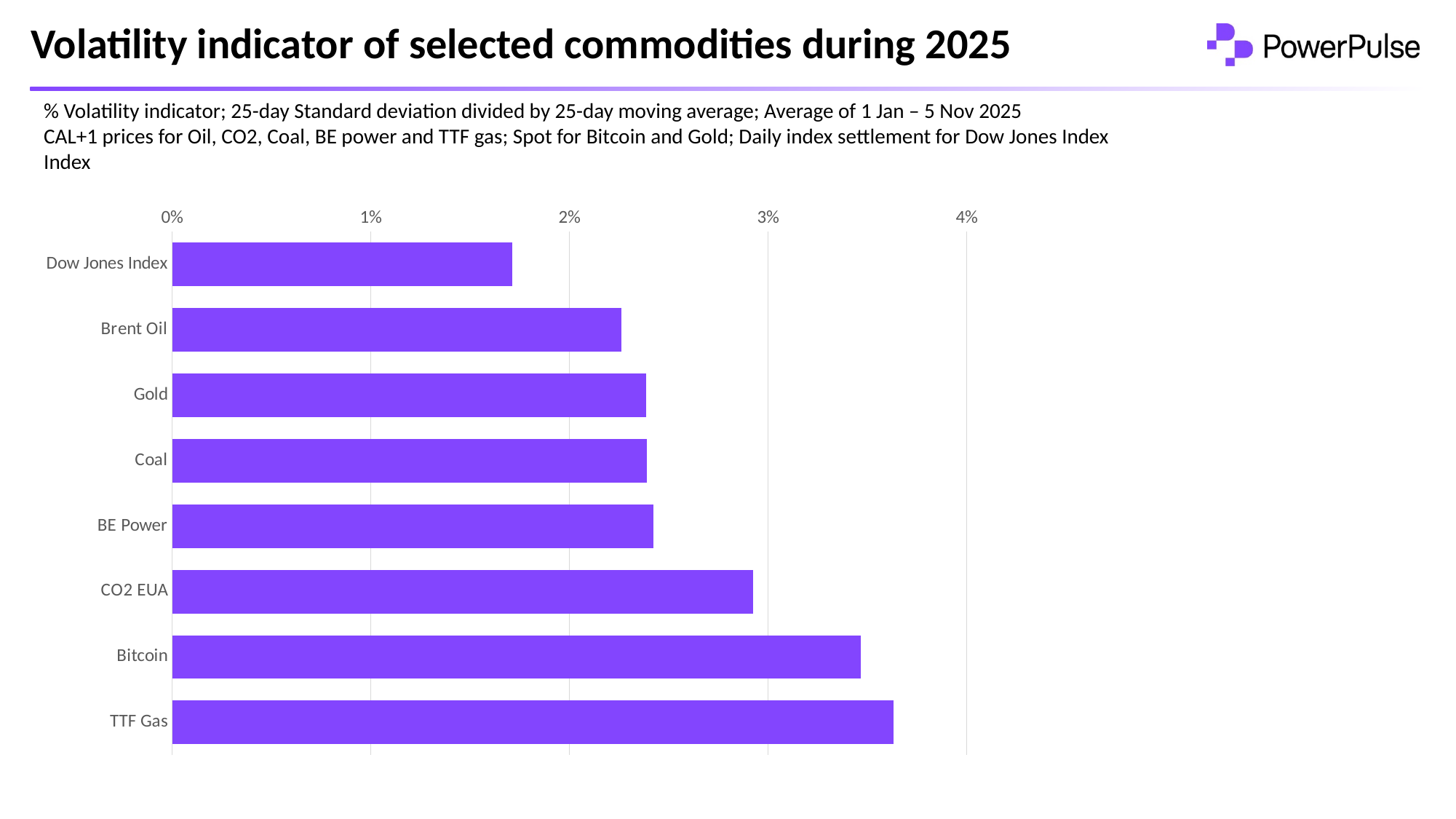
Which has a higher volatility indicator, Bitcoin or CO2 EUA? Bitcoin Which category has the highest volatility indicator? TTF Gas What kind of chart is shown on the slide? bar chart Is the value for TTF Gas greater or less than 4%? less What is the title of the slide's chart? Volatility indicator of selected commodities during 2025 Is the value for Dow Jones Index greater or less than 2%? less Do the bar values rise or fall going from the top category (Dow Jones Index) to the bottom category (TTF Gas)? rise Is the value for Bitcoin greater or less than 3%? greater How many commodities/categories are plotted in the chart? 8 Which category has the lowest volatility indicator? Dow Jones Index